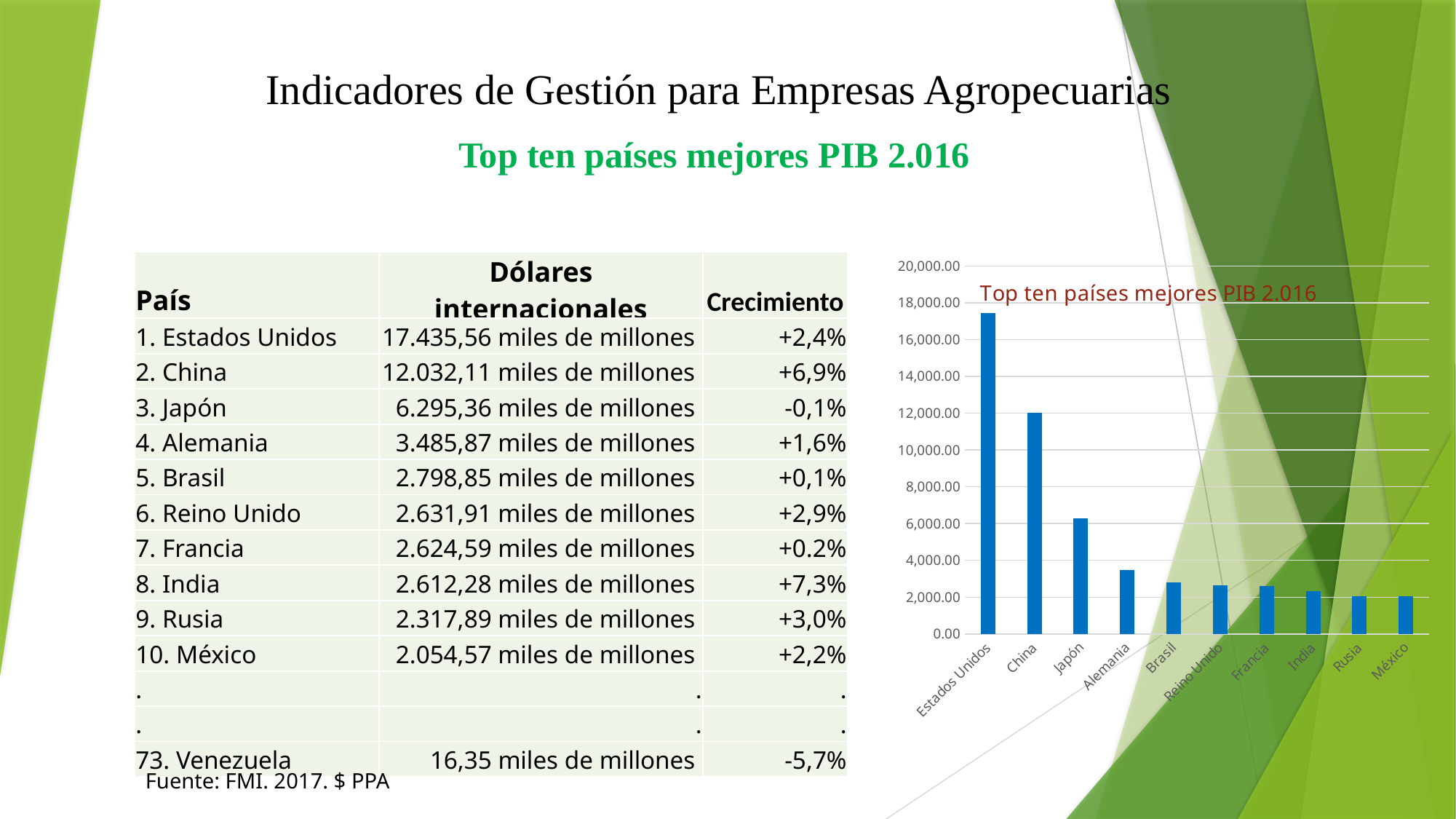
How many countries are plotted in the bar chart? 10 Is the bar for Japón greater or less than 8,000.00? less Which country has the highest bar in the chart? Estados Unidos What is the title of the chart? Top ten países mejores PIB 2.016 Is the bar for Estados Unidos greater or less than 16,000.00? greater Do the bar values rise or fall from left to right along the x axis? fall What kind of chart is shown on the slide? bar chart Is the bar for Alemania greater or less than 4,000.00? less Which bar is taller, China or Japón? China What is the highest value shown on the chart's vertical axis? 20,000.00 Which country has the lowest bar in the chart? Rusia and México (tied)